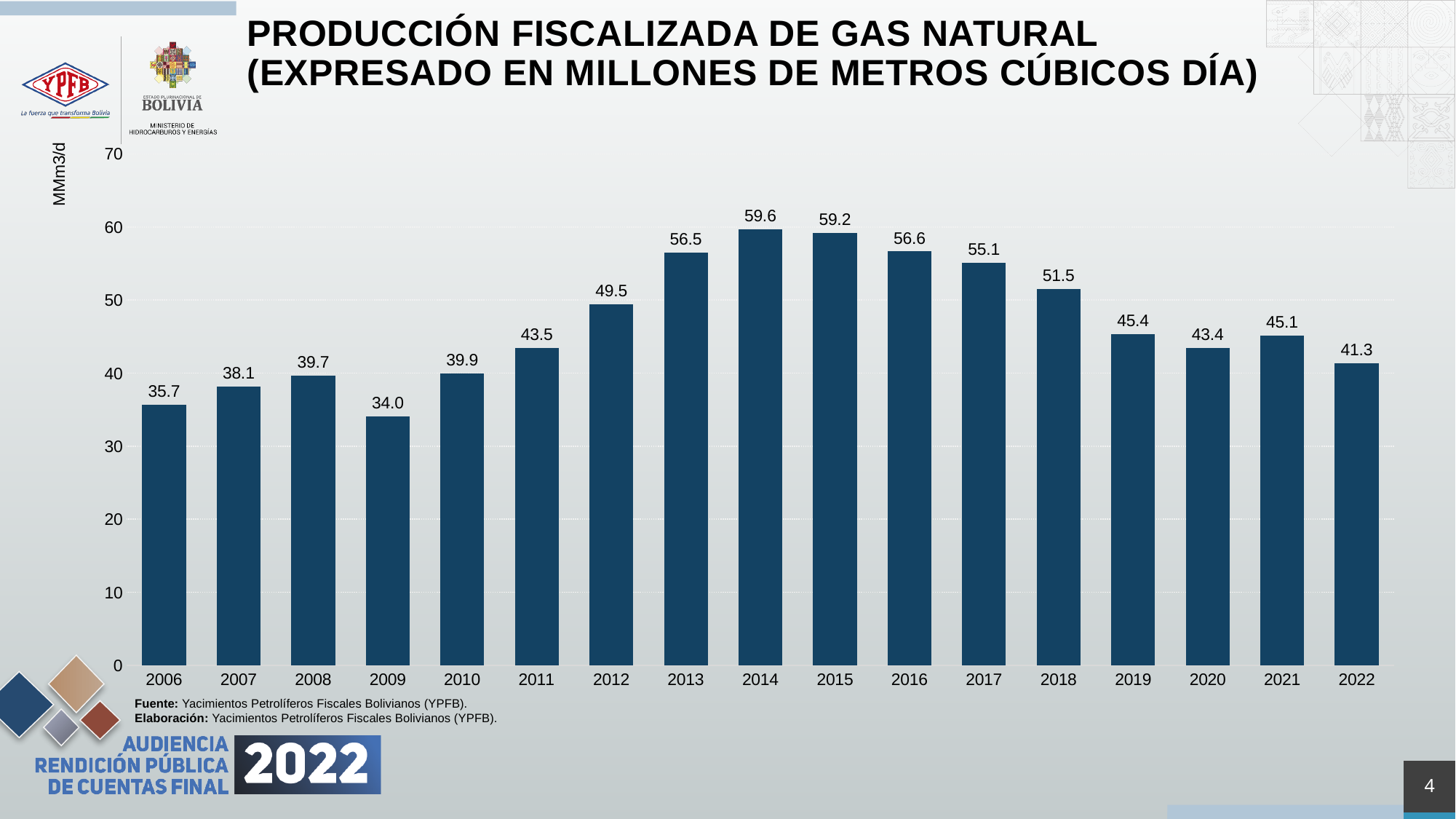
Which year had the lowest natural gas production? 2009 What was the natural gas production in 2009? 34.0 How many years are shown on the chart? 17 What was the natural gas production in 2022? 41.3 What is the difference between the production in 2014 and the production in 2022? 18.3 Which year had higher production, 2017 or 2018? 2017 Which year had the highest natural gas production? 2014 Did natural gas production rise or fall from 2014 to 2022? Fall What is the difference between the production in 2013 and the production in 2012? 7.0 What was the natural gas production in 2014? 59.6 What unit is shown on the vertical axis label of the chart? MMm3/d What kind of chart is shown on the slide? Bar chart